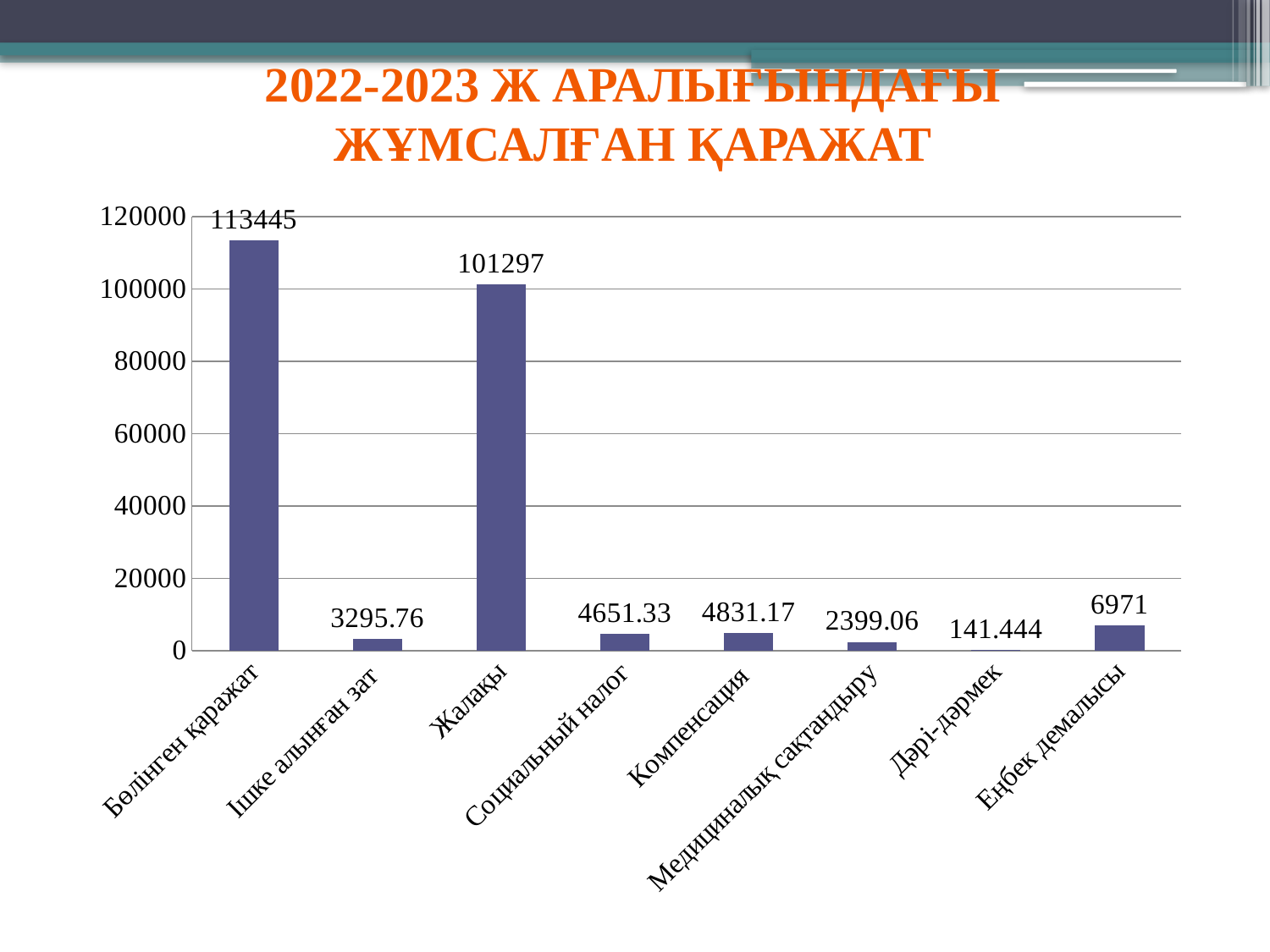
What is the value for Бөлінген қаражат? 113445 Is the value for Жалақы greater or less than 100000? greater How many categories are shown on the x axis? 8 What is the value for Еңбек демалысы? 6971 What is the difference between the values for Бөлінген қаражат and Жалақы? 12148 Which category has the highest value? Бөлінген қаражат Which is larger, the value for Компенсация or the value for Социальный налог? Компенсация What is the value for Жалақы? 101297 What is the value for Дәрі-дәрмек? 141.444 Which category has the lowest value? Дәрі-дәрмек What kind of chart is shown on the slide? bar chart What is the difference between the values for Еңбек демалысы and Ішке алынған зат? 3675.24